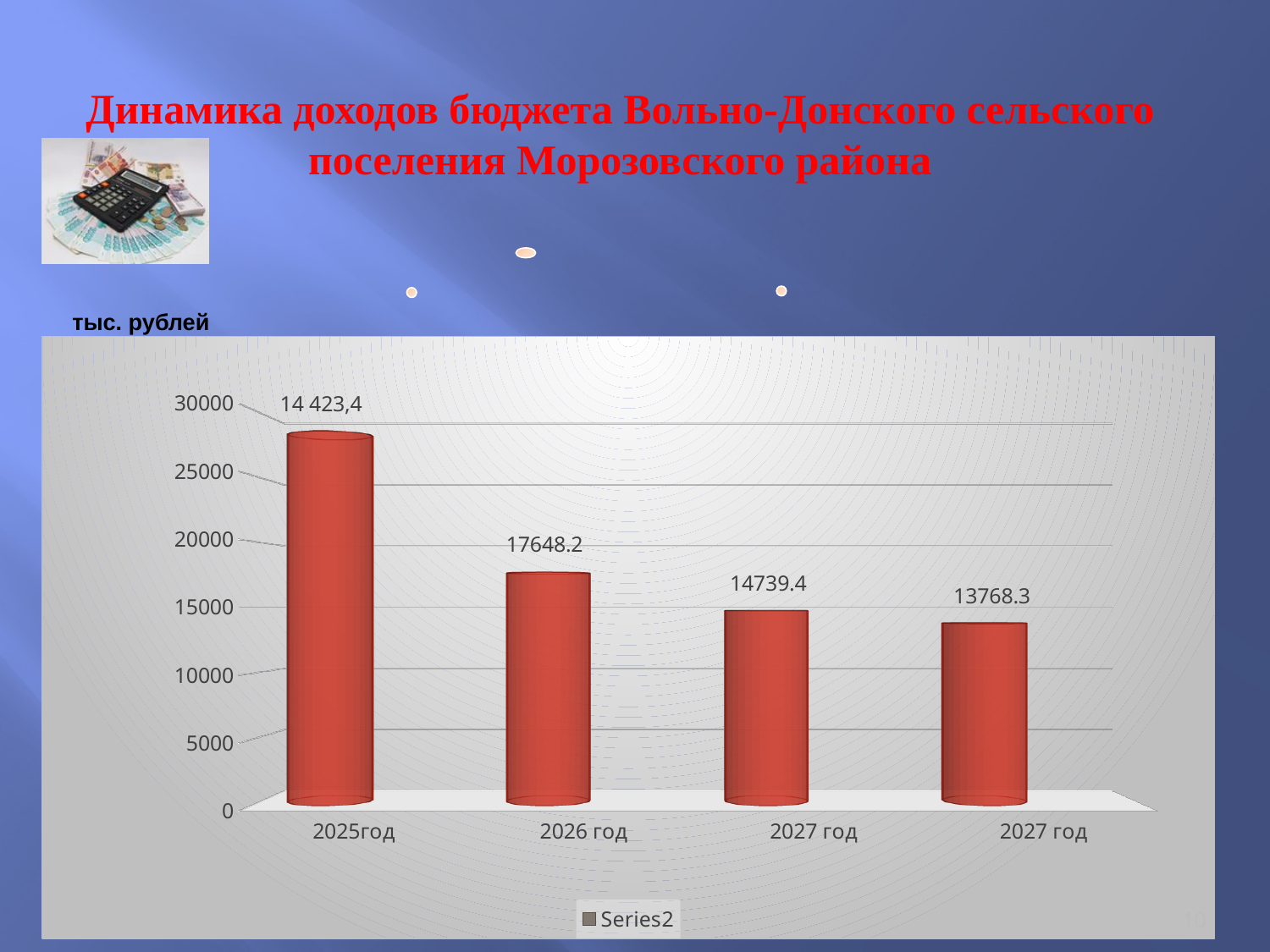
How many series does the legend list? 1 What is the difference between the labelled value for 2026 год and the labelled value of the third bar (14739.4)? 2908.8 What is the difference between the labelled values of the third bar (14739.4) and the fourth bar (13768.3)? 971.1 Is the value of the rightmost bar greater or less than 15000? less What value is labelled on the third bar from the left (the first one labelled 2027 год)? 14739.4 Is the value for 2026 год greater or less than 15000? greater What kind of chart is shown on the slide? Bar chart What value is labelled on the bar for 2026 год? 17648.2 How many bars are shown in the chart? 4 What value is labelled on the rightmost bar? 13768.3 Which is larger: the labelled value for 2026 год or the labelled value of the rightmost bar? 2026 год Which bar has the lowest labelled value? The rightmost bar (2027 год), 13768.3